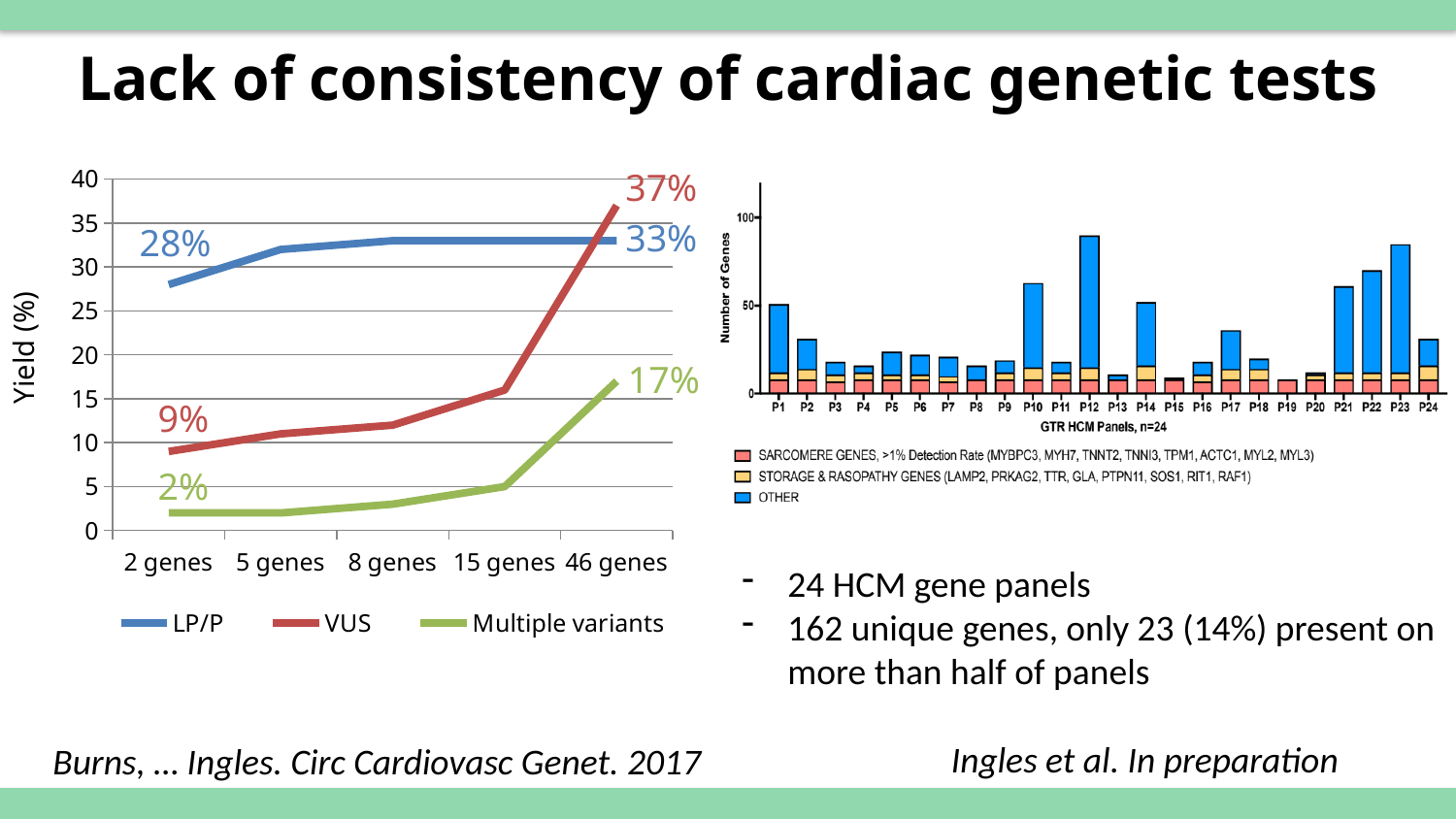
In the right-hand bar chart, which panel has the highest number of genes? P12 In the right-hand bar chart, is the number of genes for P12 greater or less than 50? greater In the left line chart, what is the yield for Multiple variants at 2 genes? 2% In the left line chart, what is the yield for VUS at 46 genes? 37% In the left line chart, how many series does the legend list? 3 In the left line chart, which series has the highest yield at 46 genes? VUS In the left line chart, what is the yield for LP/P at 46 genes? 33% In the left line chart, does the VUS yield rise or fall as the number of genes increases? rise What kind of chart is the right-hand chart showing GTR HCM panels? stacked bar chart In the left line chart, how many gene panel sizes are shown on the x axis? 5 In the left line chart, what is the yield for LP/P at 2 genes? 28% In the left line chart, by how many percentage points does the VUS yield increase from 2 genes to 46 genes? 28